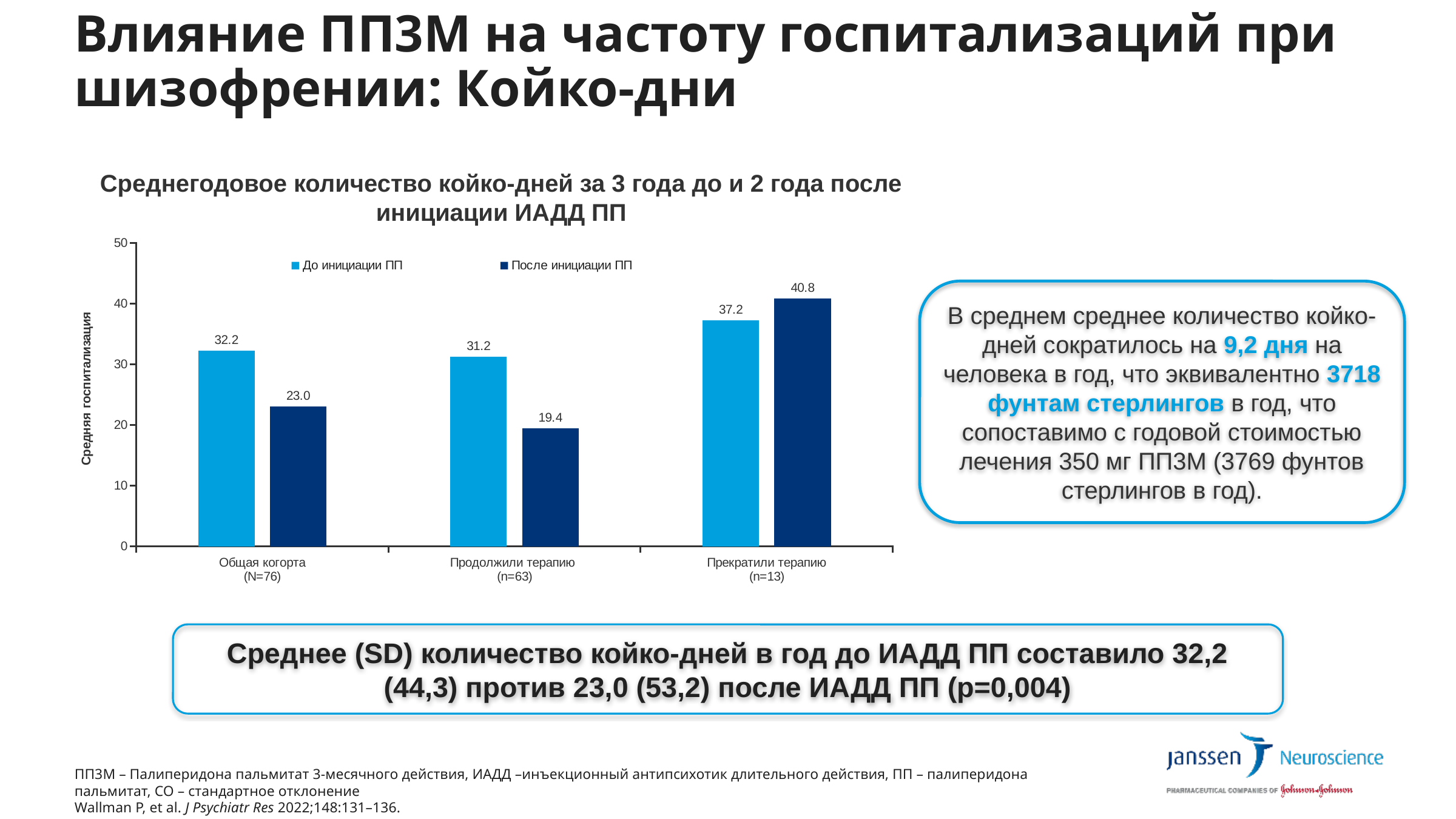
Which category has the highest value for the 'После инициации ПП' series? Прекратили терапию (n=13) What kind of chart is shown on the slide? Bar chart Which category has the lowest value for the 'После инициации ПП' series? Продолжили терапию (n=63) What is the value for 'После инициации ПП' in the 'Продолжили терапию (n=63)' category? 19.4 In the 'Прекратили терапию (n=13)' category, which is larger: 'До инициации ПП' or 'После инициации ПП'? После инициации ПП What is the difference between the 'До инициации ПП' and 'После инициации ПП' values in the 'Общая когорта (N=76)' category? 9.2 What is the value for 'После инициации ПП' in the 'Прекратили терапию (n=13)' category? 40.8 How many series does the chart legend list? 2 What is the value for 'До инициации ПП' in the 'Общая когорта (N=76)' category? 32.2 What is the label of the vertical axis of the chart? Средняя госпитализация How many categories are shown on the x axis of the chart? 3 Is the value for 'До инициации ПП' in the 'Продолжили терапию (n=63)' category greater or less than 30? greater